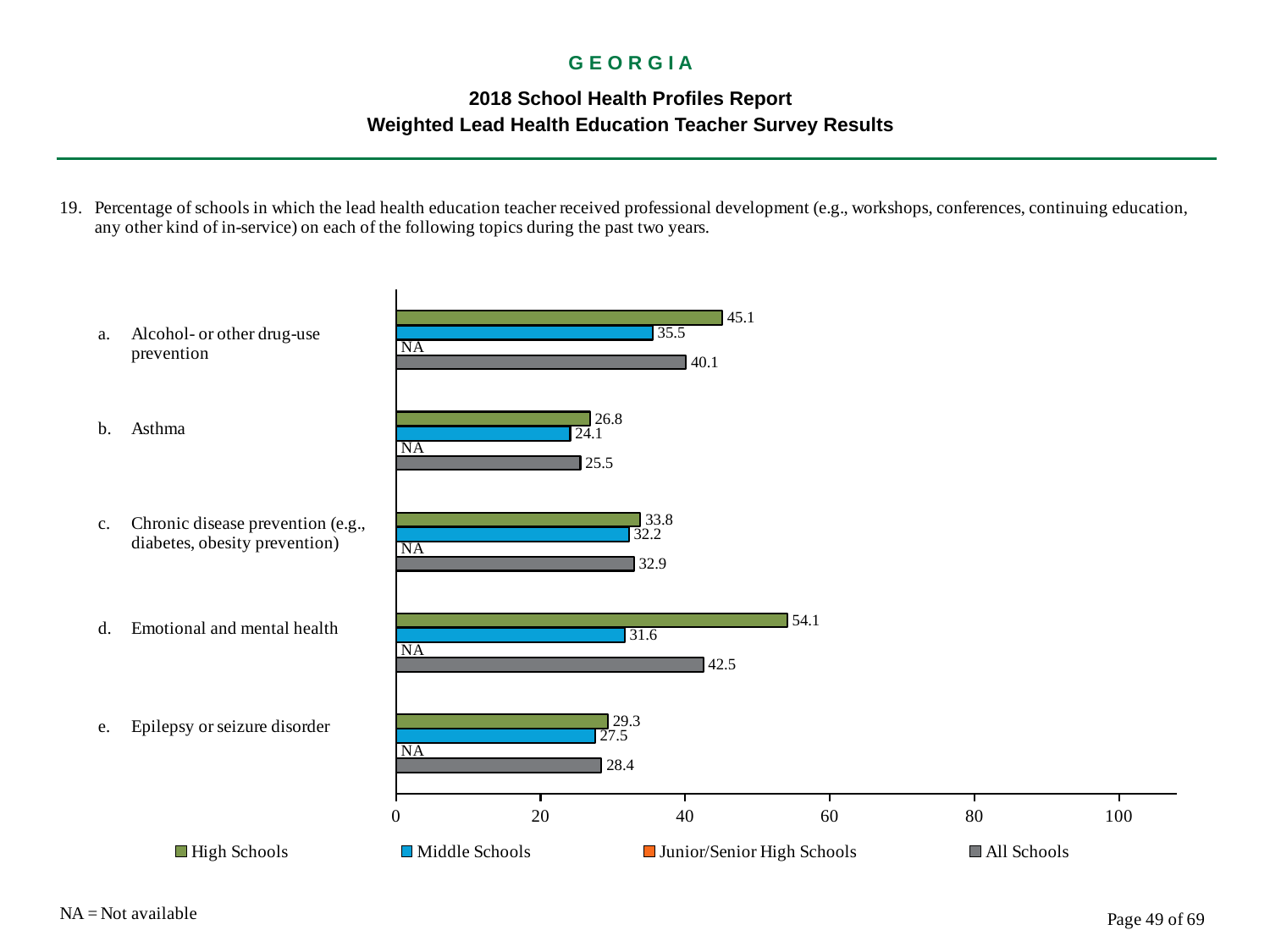
Is the High Schools value for Alcohol- or other drug-use prevention greater or less than 40? greater What kind of chart is shown on the slide? bar chart Which topic has the highest High Schools value? Emotional and mental health How many series does the legend list? 4 What value is shown for Junior/Senior High Schools for Epilepsy or seizure disorder? NA What is the All Schools value for Alcohol- or other drug-use prevention? 40.1 Which topic has the lowest All Schools value? Asthma How many topics are shown on the chart? 5 What is the Middle Schools value for Asthma? 24.1 Which is larger for Chronic disease prevention: the High Schools value or the All Schools value? High Schools What is the difference between the High Schools and Middle Schools values for Emotional and mental health? 22.5 What is the High Schools value for Emotional and mental health? 54.1